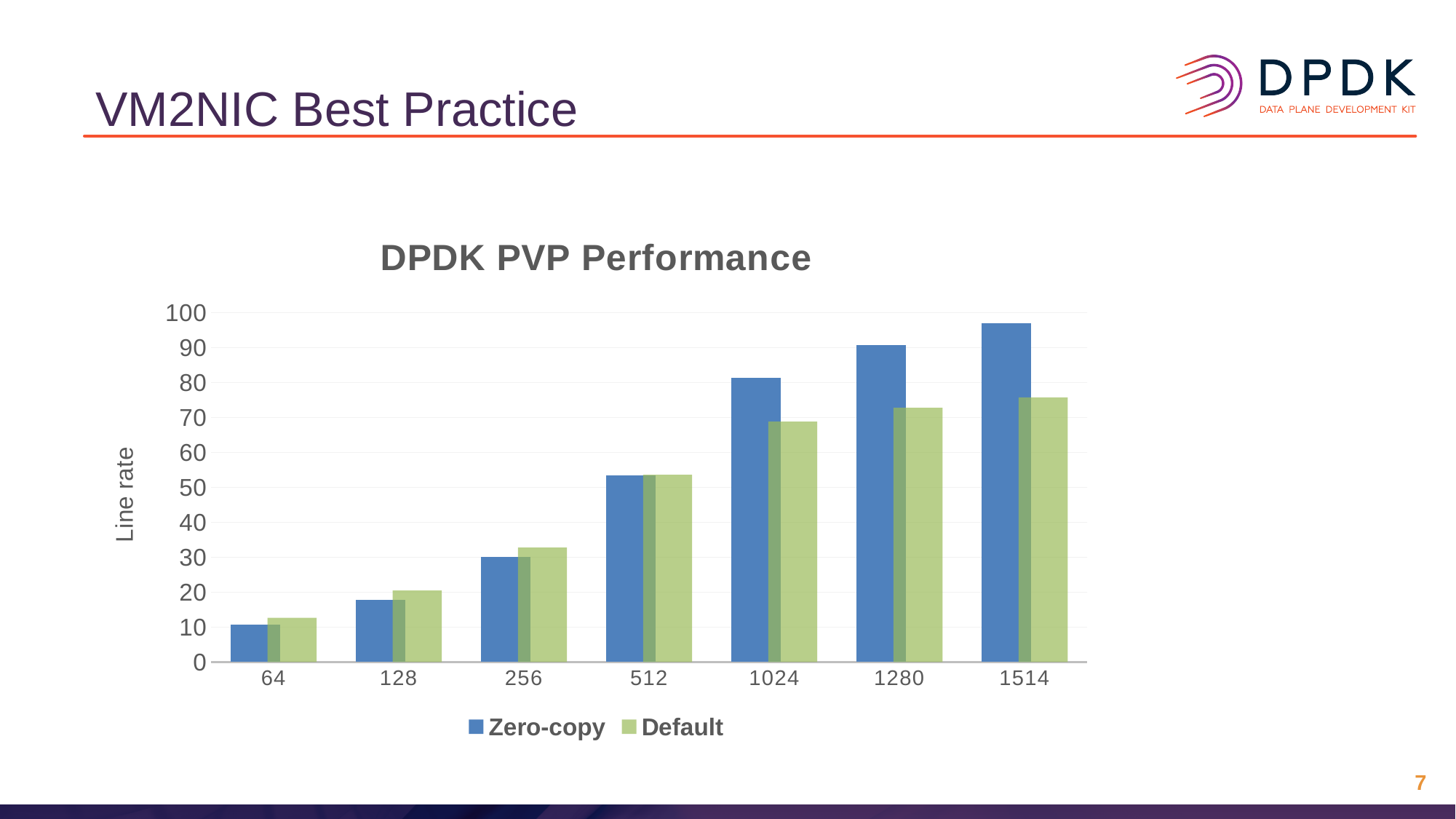
Is the Zero-copy value for 1514 greater or less than 90? greater Is the Default value for 1024 greater or less than 70? less At packet size 1280, which series has the larger value, Zero-copy or Default? Zero-copy What type of chart is shown on the slide? bar chart How many packet-size categories are shown on the x axis? 7 Is the Zero-copy value for 256 greater or less than 40? less At packet size 256, which series has the larger value, Zero-copy or Default? Default Which packet size has the lowest Default value? 64 How many series does the legend list? 2 Do the Zero-copy values rise or fall as packet size increases along the x axis? rise What is the title of the chart? DPDK PVP Performance Which packet size has the highest Zero-copy value? 1514